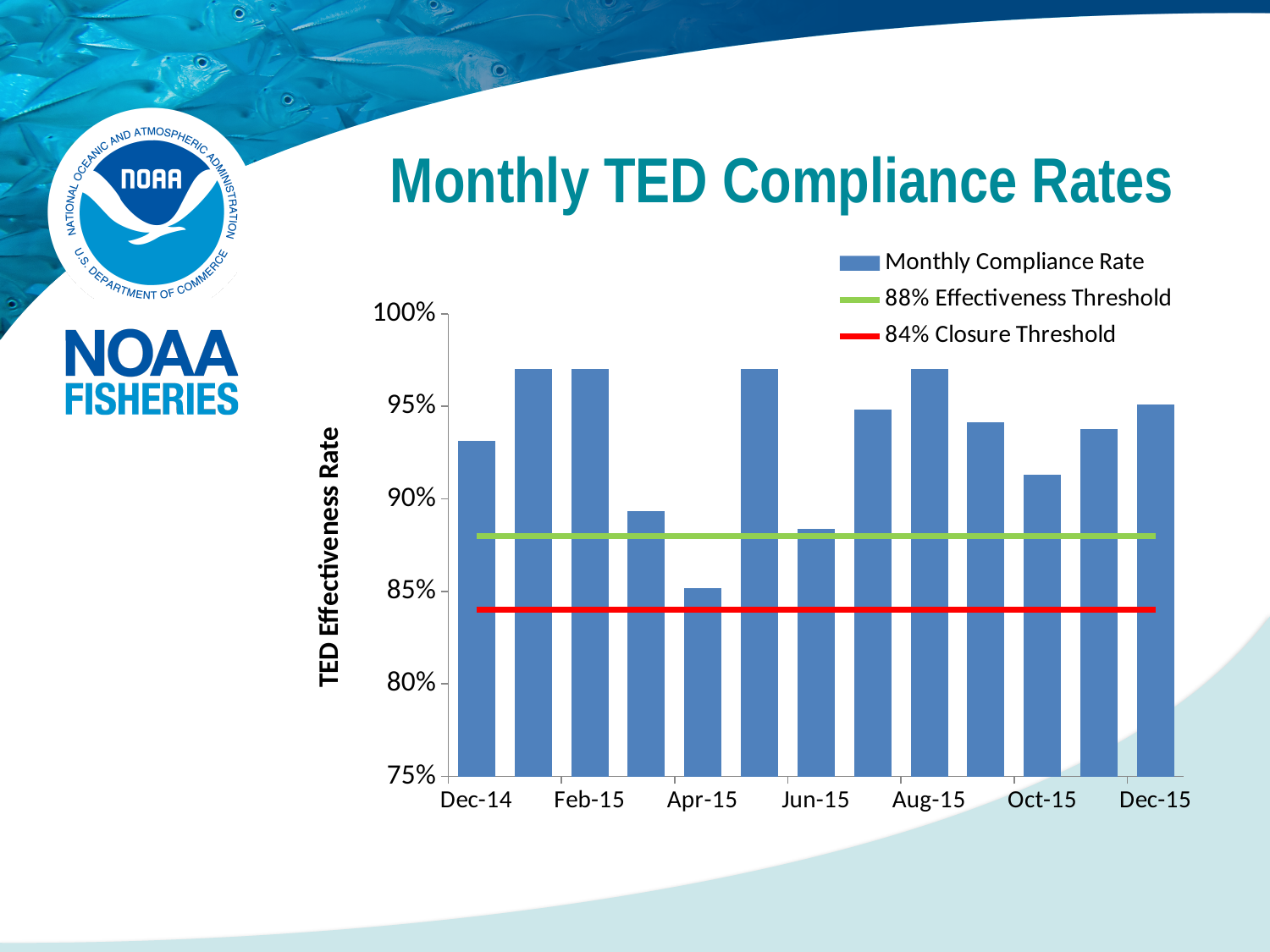
Is the Monthly Compliance Rate for Jun-15 greater or less than 90%? less Is the Monthly Compliance Rate for Dec-14 greater or less than 90%? greater What value does the red line in the chart represent, according to the legend? 84% Closure Threshold Which month has the higher Monthly Compliance Rate, Feb-15 or Apr-15? Feb-15 Which month has the higher Monthly Compliance Rate, Oct-15 or Dec-15? Dec-15 What kind of chart is shown on the slide? Bar chart Is the Monthly Compliance Rate for Apr-15 greater or less than 90%? less How many series does the legend list? 3 How many monthly bars are plotted in the chart? 13 Which month has the lowest Monthly Compliance Rate? Apr-15